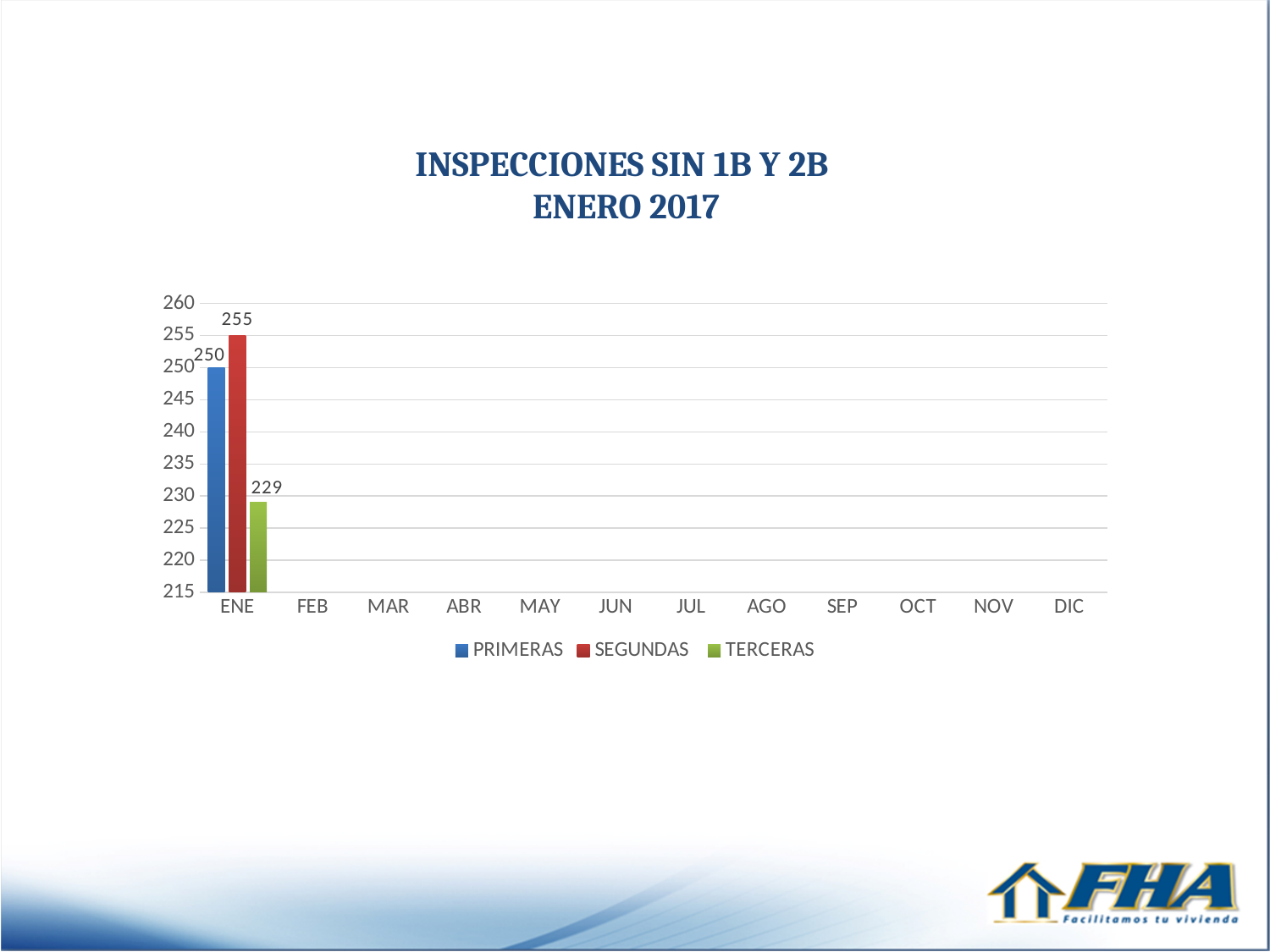
What is the value for SEGUNDAS in ENE? 255 What is the value for TERCERAS in ENE? 229 What is the difference between SEGUNDAS and PRIMERAS in ENE? 5 Which series has the highest value in ENE? SEGUNDAS What is the value for PRIMERAS in ENE? 250 How many month categories are shown on the x axis? 12 How many series does the legend list? 3 Is the value for TERCERAS in ENE greater or less than 240? less What kind of chart is shown on the slide? bar chart Which series has the lowest value in ENE? TERCERAS What is the difference between PRIMERAS and TERCERAS in ENE? 21 Which is larger in ENE, PRIMERAS or TERCERAS? PRIMERAS